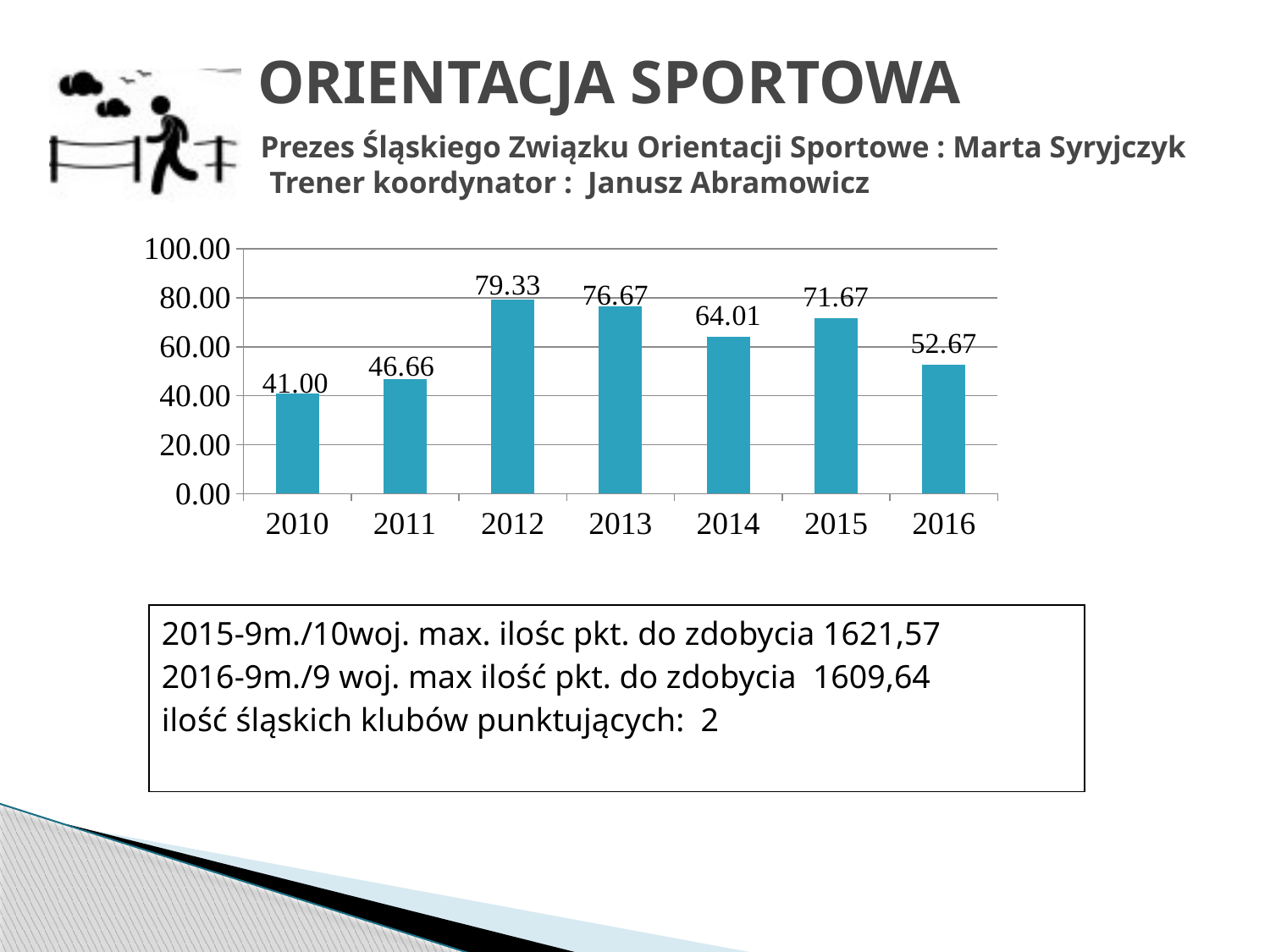
What is the difference between the values for 2012 and 2010? 38.33 Which year has the highest value? 2012 What is the value for 2010? 41.00 Do the values rise or fall from 2010 to 2012? rise What is the value for 2012? 79.33 How many years are shown on the x axis? 7 What is the value for 2016? 52.67 What kind of chart is shown on the slide? bar chart Which year has the lowest value? 2010 Is the value for 2013 greater or less than 60.00? greater What is the difference between the values for 2015 and 2016? 19.00 Which is larger, the value for 2014 or the value for 2015? 2015